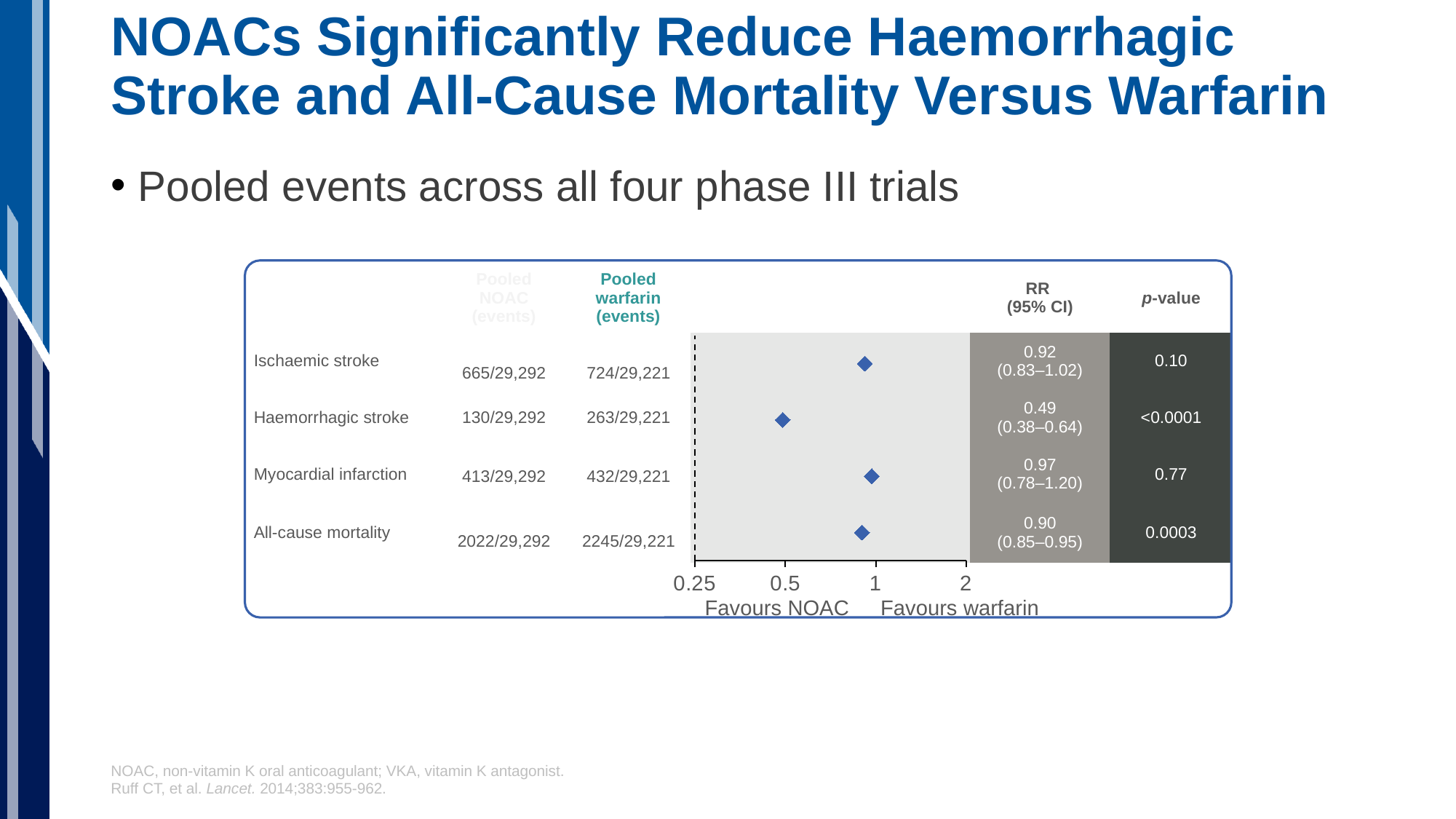
Which outcome has the highest RR? Myocardial infarction What is the RR for All-cause mortality? 0.90 Which has the larger RR, Ischaemic stroke or All-cause mortality? Ischaemic stroke How many outcomes are plotted in the forest plot? 4 Is the RR for Haemorrhagic stroke greater or less than 1? less What is the RR (95% CI) value for Haemorrhagic stroke? 0.49 (0.38–0.64) How many pooled warfarin events are shown for Haemorrhagic stroke? 263/29,221 Which outcome has the lowest RR? Haemorrhagic stroke What is the difference between the RR for Myocardial infarction and the RR for Haemorrhagic stroke? 0.48 What is the p-value for All-cause mortality? 0.0003 What label appears on the left side below the x axis of the plot? Favours NOAC What is the 95% CI for Ischaemic stroke? (0.83–1.02)